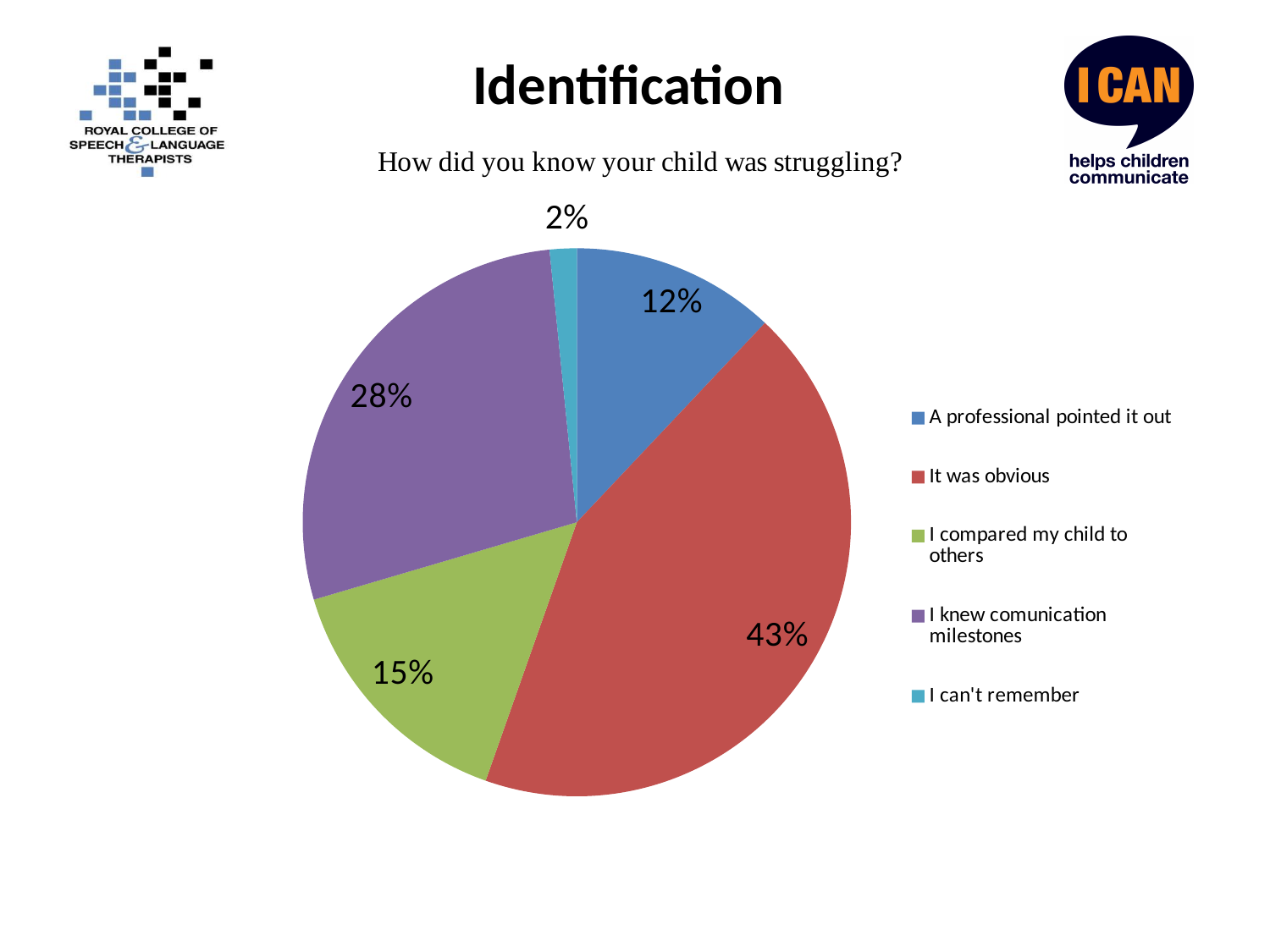
What percentage of respondents said "A professional pointed it out"? 12% How many categories does the pie chart have? 5 Which response has the largest share of the pie? It was obvious Which response has the smallest share of the pie? I can't remember What percentage of respondents said "It was obvious"? 43% What colour is the slice for "It was obvious"? red What type of chart is shown on the slide? pie chart What percentage of respondents said "I knew comunication milestones"? 28% Which is larger: the share for "I compared my child to others" or the share for "A professional pointed it out"? I compared my child to others What percentage of respondents said "I compared my child to others"? 15% What percentage of respondents said "I can't remember"? 2% What is the difference in percentage points between "It was obvious" and "I knew comunication milestones"? 15